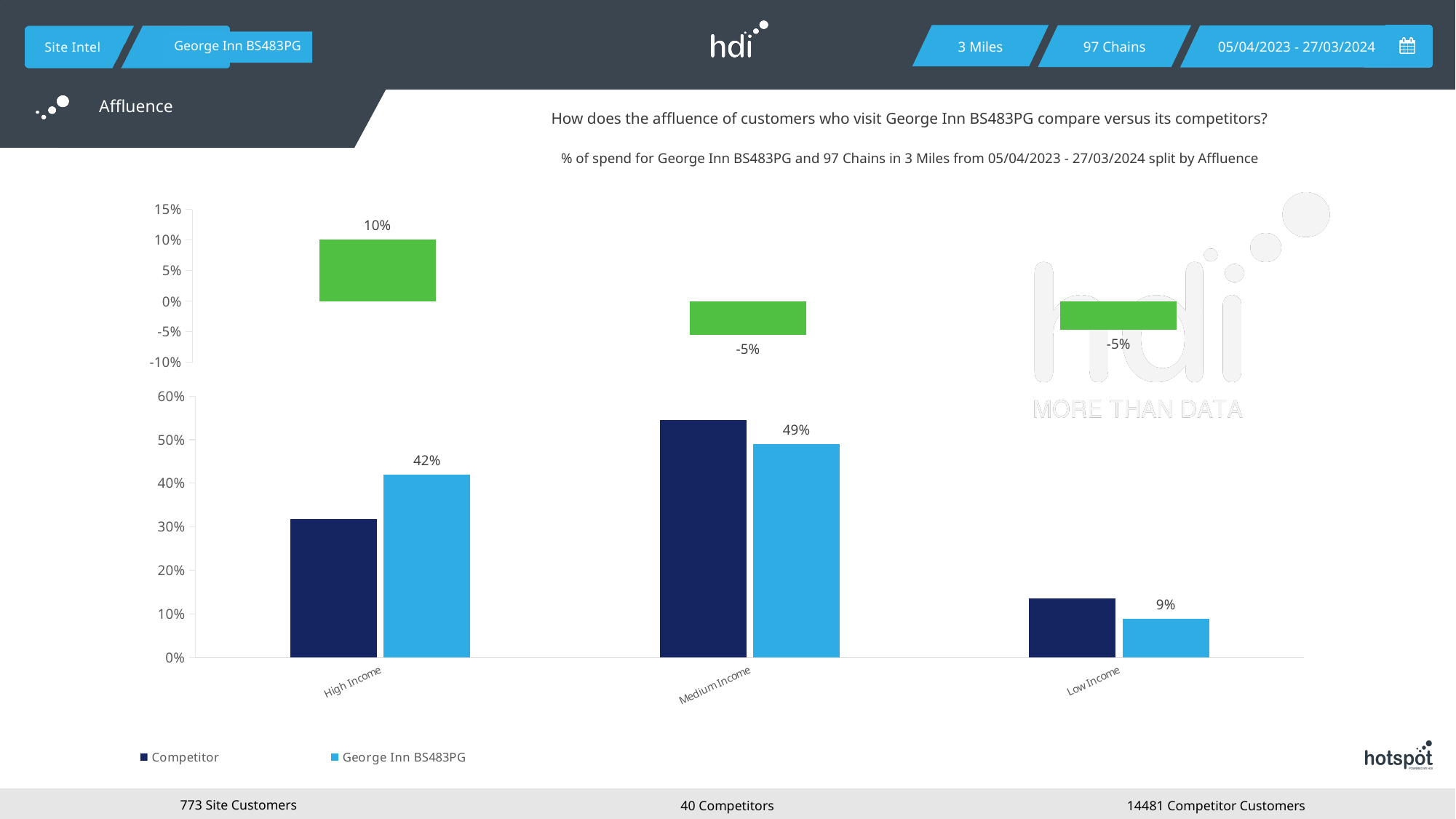
In the bottom chart, which category has the lowest value for George Inn BS483PG? Low Income In the bottom chart, which category has the highest value for George Inn BS483PG? Medium Income In the bottom chart, is the Competitor value for High Income greater or less than 40%? less In the top chart, what is the value shown for the High Income category? 10% In the bottom chart, what is the value for George Inn BS483PG in the High Income category? 42% In the bottom chart, what is the value for George Inn BS483PG in the Medium Income category? 49% In the bottom chart, is the Competitor value for Medium Income greater or less than 50%? greater In the top chart, what is the value shown for the Medium Income category? -5% How many series does the legend of the bottom chart list? 2 In the bottom chart, which is larger for the Low Income category: Competitor or George Inn BS483PG? Competitor In the bottom chart, what is the difference between the George Inn BS483PG values for Medium Income and High Income? 7% In the bottom chart, what is the value for George Inn BS483PG in the Low Income category? 9%